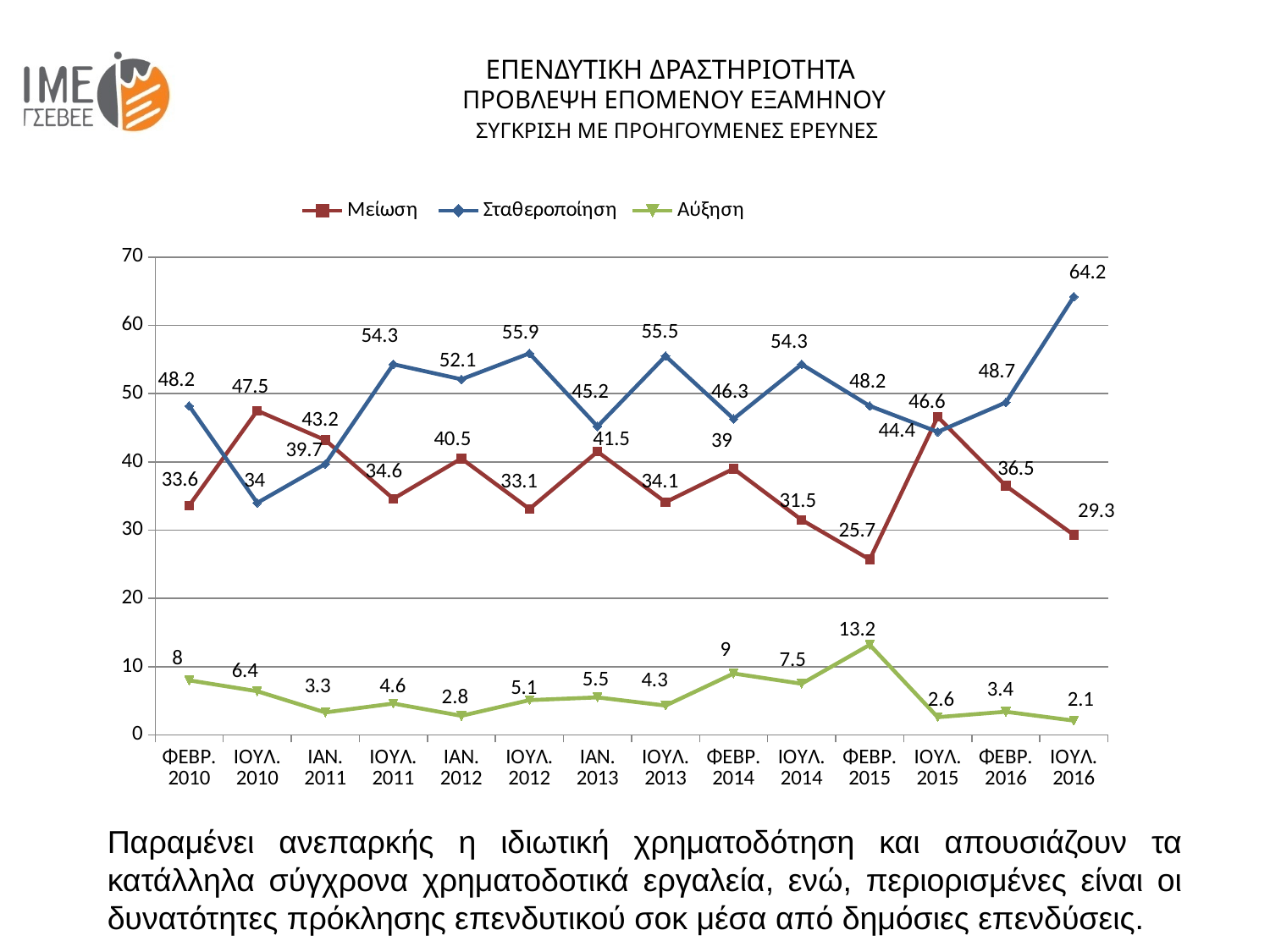
In which period does Αύξηση reach its highest value? ΦΕΒΡ. 2015 What kind of chart is shown on the slide? line chart What is the difference between Σταθεροποίηση and Μείωση in ΙΟΥΛ. 2016? 34.9 Is the value of Μείωση for ΙΟΥΛ. 2015 greater or less than 40? greater Which is larger in ΙΟΥΛ. 2010, Μείωση or Σταθεροποίηση? Μείωση How many time periods are shown on the x axis? 14 Does Μείωση rise or fall from ΙΟΥΛ. 2015 to ΙΟΥΛ. 2016? fall What is the value of Αύξηση for ΦΕΒΡ. 2014? 9 What is the value of Μείωση for ΦΕΒΡ. 2015? 25.7 How many series does the legend list? 3 What is the value of Σταθεροποίηση for ΙΟΥΛ. 2016? 64.2 In which period does Σταθεροποίηση have its lowest value? ΙΟΥΛ. 2010